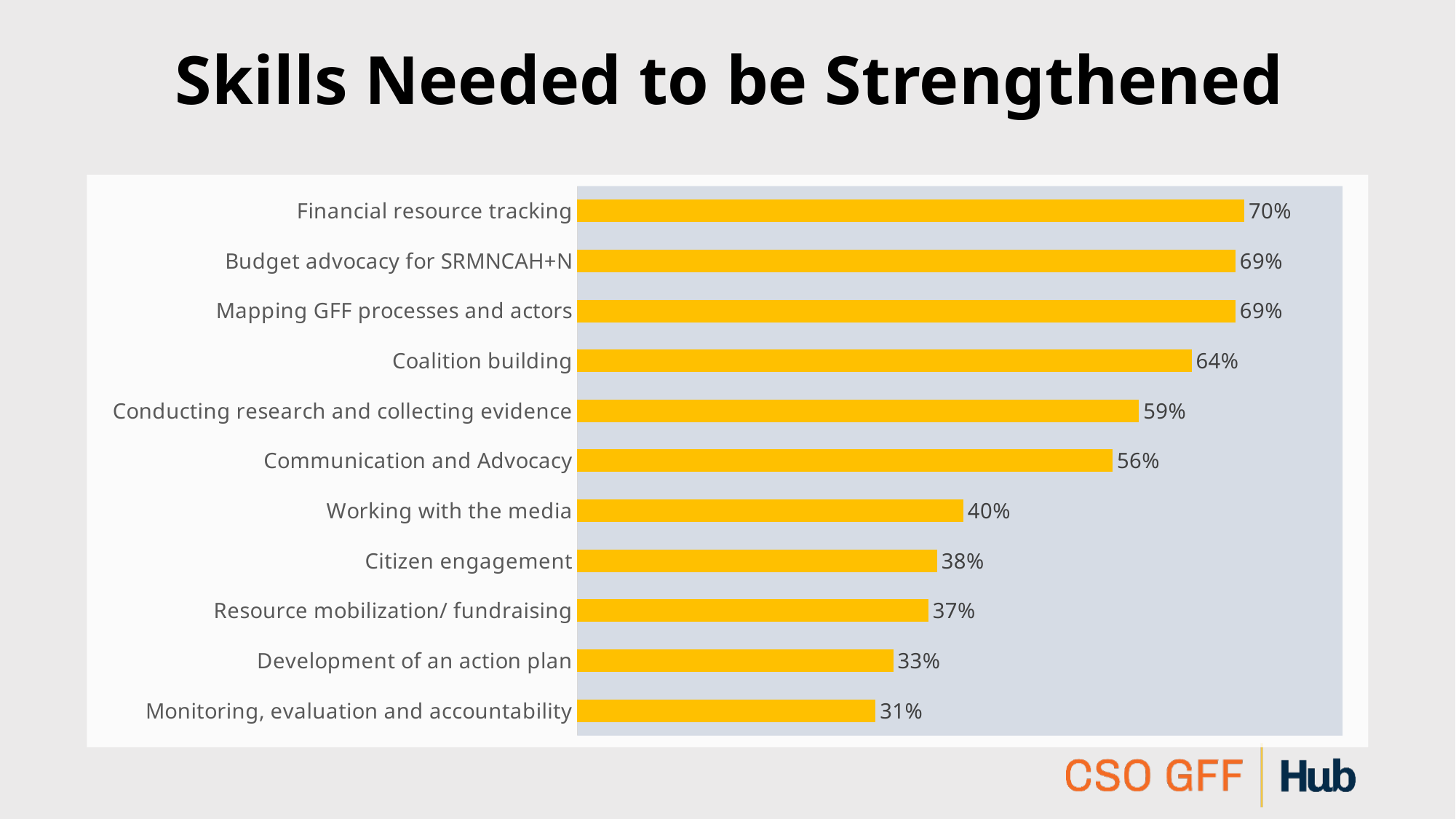
What is the title of the slide? Skills Needed to be Strengthened Which skill has the lowest value? Monitoring, evaluation and accountability What is the value for Financial resource tracking? 70% Which is larger, the value for Citizen engagement or the value for Development of an action plan? Citizen engagement Which skill has the highest value? Financial resource tracking What is the difference between the values for Coalition building and Communication and Advocacy? 8% What is the value for Coalition building? 64% What is the value for Monitoring, evaluation and accountability? 31% What is the value for Working with the media? 40% How many skills are shown in the chart? 11 What kind of chart is shown on the slide? Bar chart What is the difference between the values for Financial resource tracking and Monitoring, evaluation and accountability? 39%